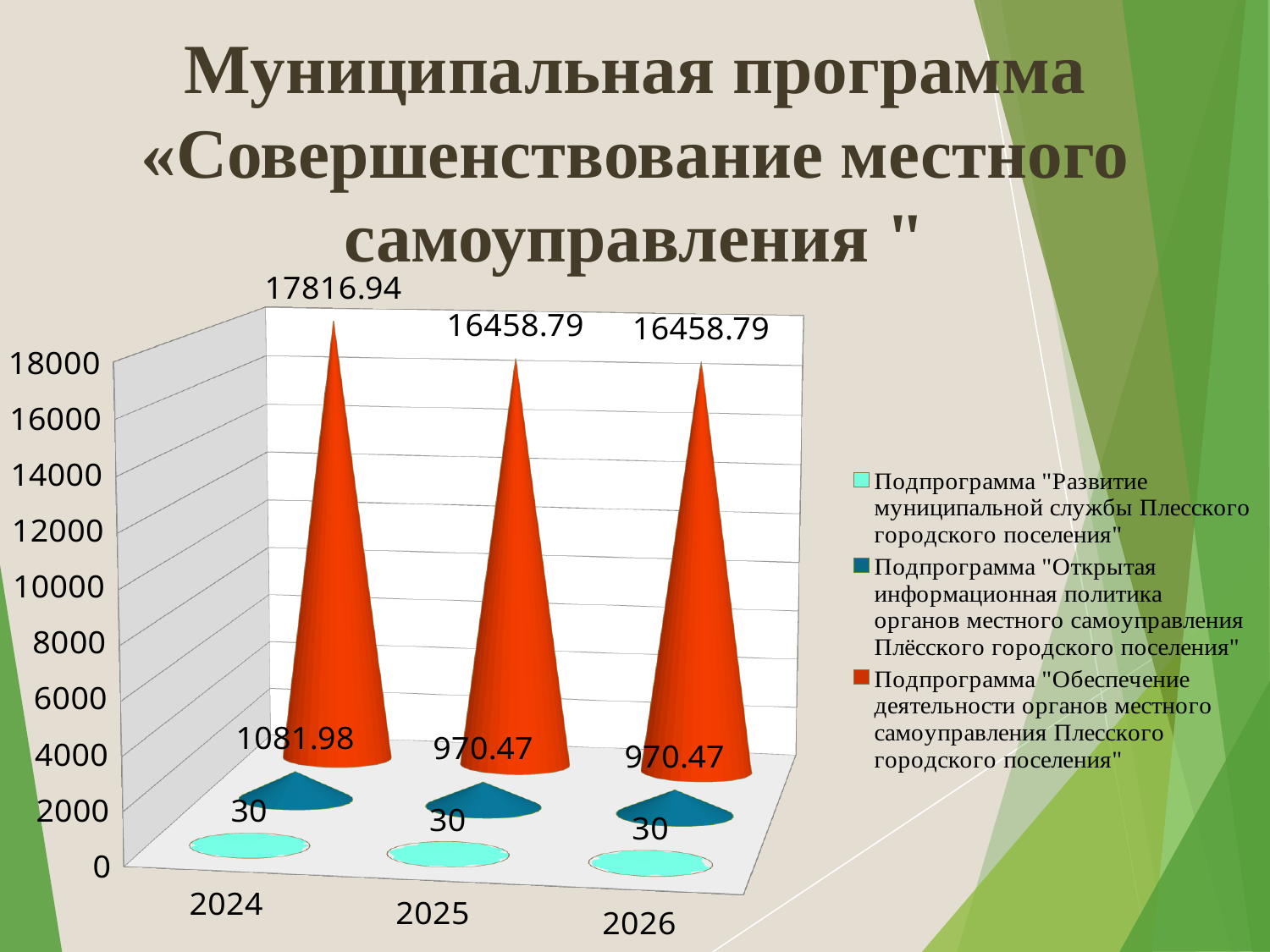
What is the difference between the 2024 and 2025 values for Подпрограмма "Открытая информационная политика органов местного самоуправления Плёсского городского поселения"? 111.51 How many series does the legend list? 3 Which is larger in 2024: the value for Подпрограмма "Открытая информационная политика" or the value for Подпрограмма "Развитие муниципальной службы"? Подпрограмма "Открытая информационная политика" What is the value for 2025 for the series Подпрограмма "Развитие муниципальной службы Плесского городского поселения"? 30 What is the value for 2025 for the series Подпрограмма "Обеспечение деятельности органов местного самоуправления Плесского городского поселения"? 16458.79 In which year is the value for Подпрограмма "Обеспечение деятельности органов местного самоуправления Плесского городского поселения" highest? 2024 What is the value for 2024 for the series Подпрограмма "Открытая информационная политика органов местного самоуправления Плёсского городского поселения"? 1081.98 What is the value for 2026 for the series Подпрограмма "Открытая информационная политика органов местного самоуправления Плёсского городского поселения"? 970.47 Which colour represents Подпрограмма "Обеспечение деятельности органов местного самоуправления Плесского городского поселения" in the chart? Red What is the value for 2024 for the series Подпрограмма "Обеспечение деятельности органов местного самоуправления Плесского городского поселения"? 17816.94 How many years are shown on the x axis of the chart? 3 What is the difference between the 2024 and 2025 values for Подпрограмма "Обеспечение деятельности органов местного самоуправления Плесского городского поселения"? 1358.15